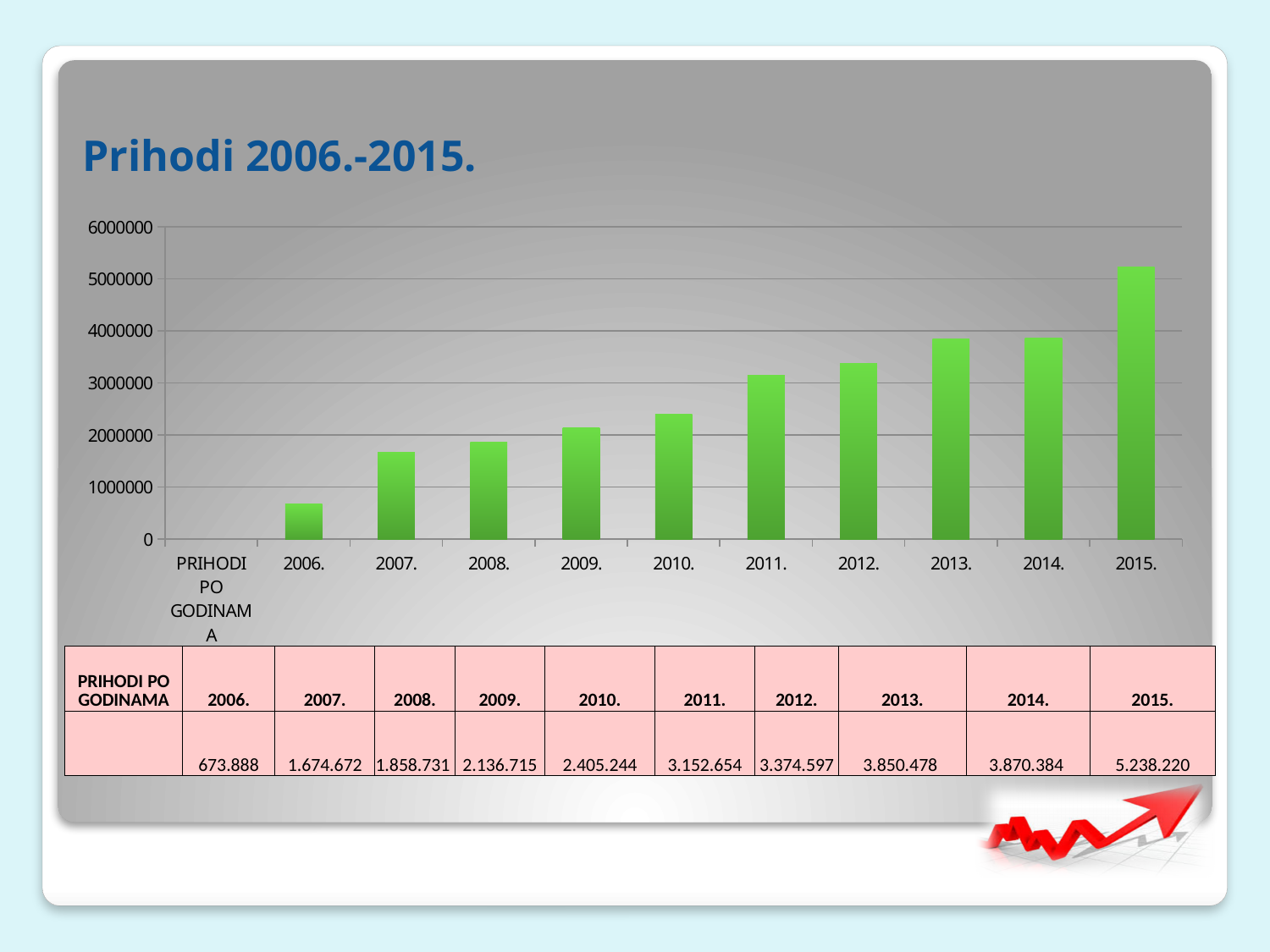
Which year has the highest value? 2015. What is the difference between the values for 2007. and 2006.? 1.000.784 What is the value for 2015.? 5.238.220 Do the values generally rise or fall from 2006. to 2015.? rise Which year has the lowest value? 2006. Which is larger, the value for 2011. or the value for 2012.? 2012. Is the value for 2010. greater or less than 2000000? greater What type of chart is shown on the slide? bar chart What is the title of the slide? Prihodi 2006.-2015. What is the value for 2006.? 673.888 What is the difference between the values for 2015. and 2014.? 1.367.836 What is the value for 2011.? 3.152.654